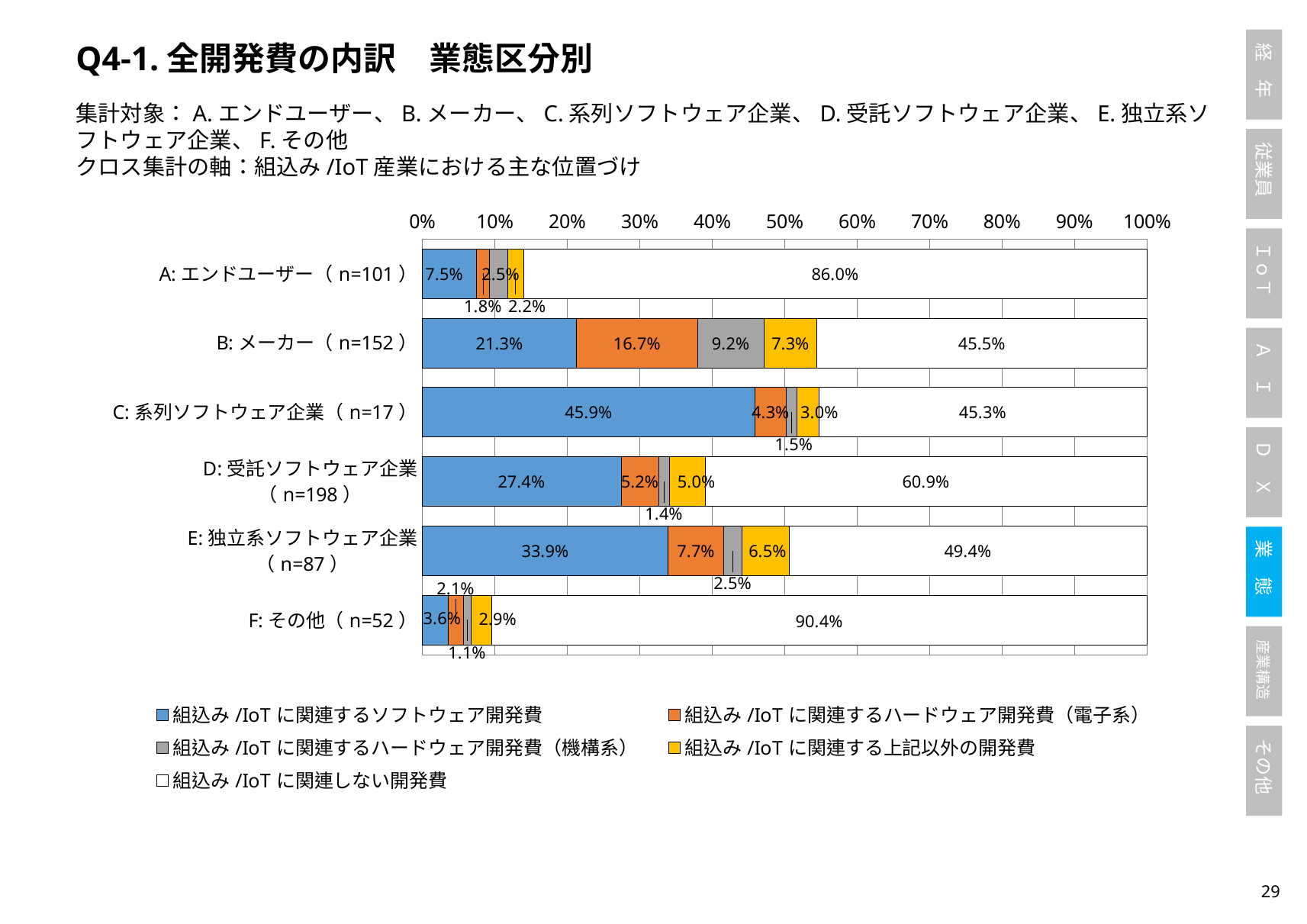
How many series does the legend list? 5 What type of chart is shown on the slide? Stacked bar chart What is the value of 組込み/IoTに関連する上記以外の開発費 for D: 受託ソフトウェア企業? 5.0% Which category has the lowest share of 組込み/IoTに関連しない開発費? C: 系列ソフトウェア企業 How many categories (business types) are plotted on the chart? 6 What is the value of 組込み/IoTに関連するハードウェア開発費（電子系） for E: 独立系ソフトウェア企業? 7.7% What is the value of 組込み/IoTに関連しない開発費 for F: その他? 90.4% What is the difference between the 組込み/IoTに関連しない開発費 values for A: エンドユーザー and B: メーカー? 40.5% What is the value of 組込み/IoTに関連するソフトウェア開発費 for B: メーカー? 21.3% Which category has the highest share of 組込み/IoTに関連するソフトウェア開発費? C: 系列ソフトウェア企業 What is the sample size (n) shown for D: 受託ソフトウェア企業? 198 Which is larger: the 組込み/IoTに関連するハードウェア開発費（機構系） value for B: メーカー or for E: 独立系ソフトウェア企業? B: メーカー